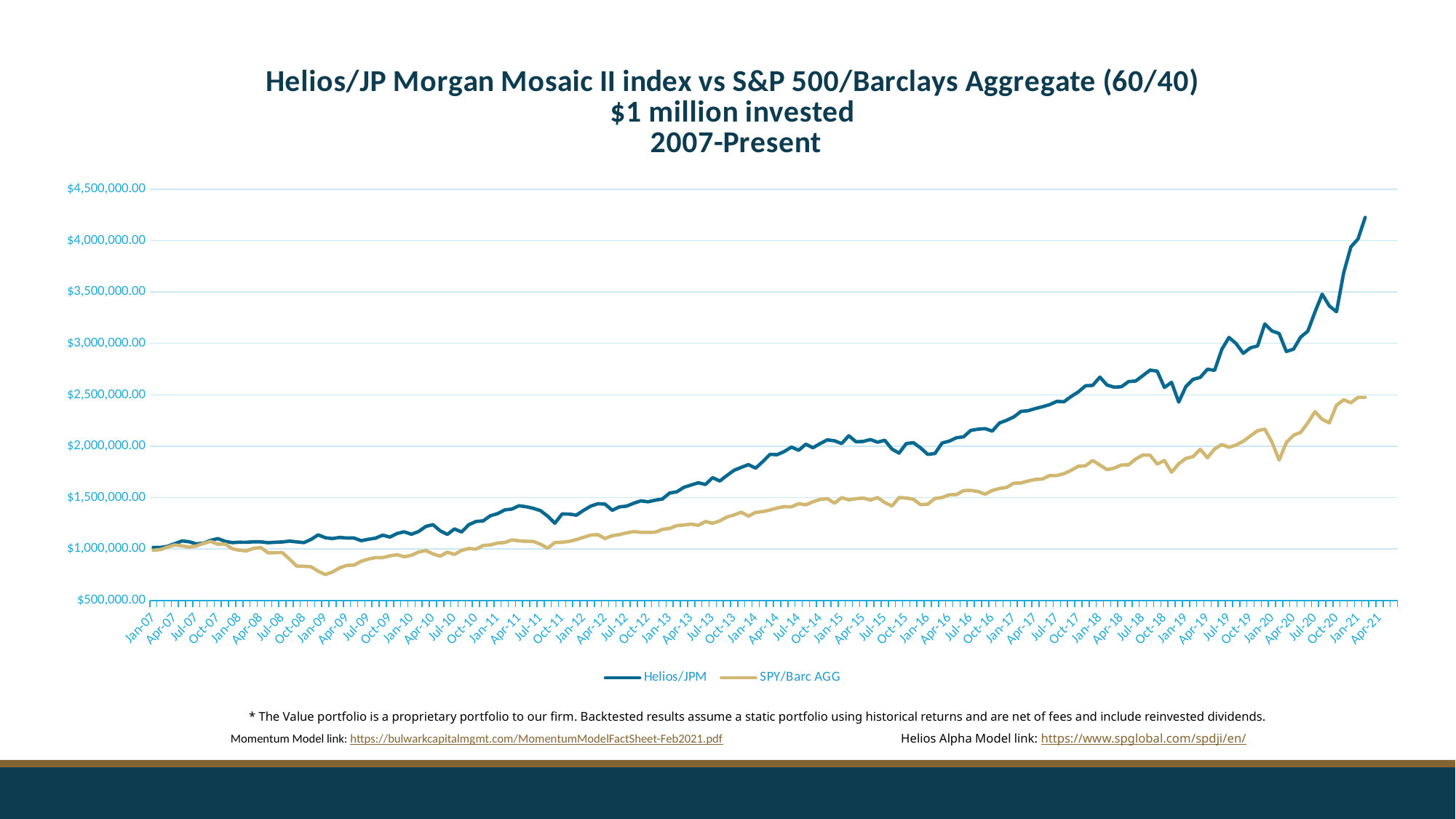
Overall, do the values of the Helios/JPM series rise or fall from Jan-07 to Apr-21? rise Is the final value of the Helios/JPM series greater or less than $4,000,000.00? greater How many series does the legend list? 2 Which series has the higher value at the end of the chart (2021)? Helios/JPM Is the value of SPY/Barc AGG at Jan-17 greater or less than $1,500,000.00? greater Which series falls below its starting value of $1,000,000.00 during 2008-2009? SPY/Barc AGG What initial investment amount does the chart title state? $1 million What are the two series named in the legend? Helios/JPM and SPY/Barc AGG Is the value of SPY/Barc AGG at Jan-09 greater or less than $1,000,000.00? less What kind of chart is shown on the slide? line chart